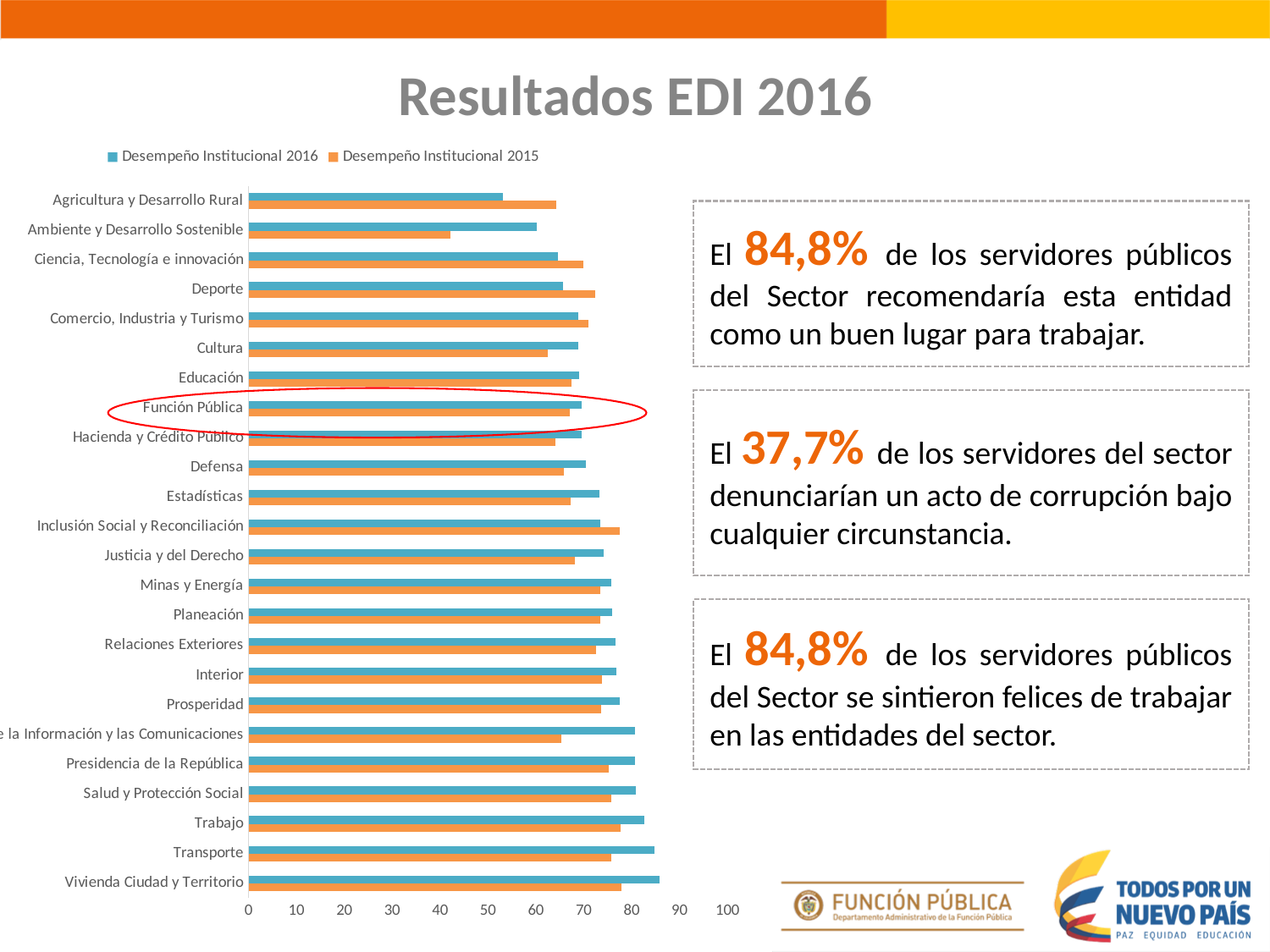
How many series does the chart legend list? 2 Which sector has the lowest Desempeño Institucional 2015 value? Ambiente y Desarrollo Sostenible Which sector has the lowest Desempeño Institucional 2016 value? Agricultura y Desarrollo Rural Which colour represents Desempeño Institucional 2015 in the chart? orange For Ambiente y Desarrollo Sostenible, which is larger: the Desempeño Institucional 2016 value or the 2015 value? Desempeño Institucional 2016 Is the Desempeño Institucional 2015 value for Ambiente y Desarrollo Sostenible greater or less than 50? less What kind of chart is shown on the slide? bar chart Which sector has the highest Desempeño Institucional 2016 value? Vivienda Ciudad y Territorio How many sectors (categories) are plotted in the chart? 24 For Inclusión Social y Reconciliación, which is larger: the Desempeño Institucional 2016 value or the 2015 value? Desempeño Institucional 2015 Is the Desempeño Institucional 2016 value for Agricultura y Desarrollo Rural greater or less than 60? less Is the Desempeño Institucional 2016 value for Vivienda Ciudad y Territorio greater or less than 80? greater